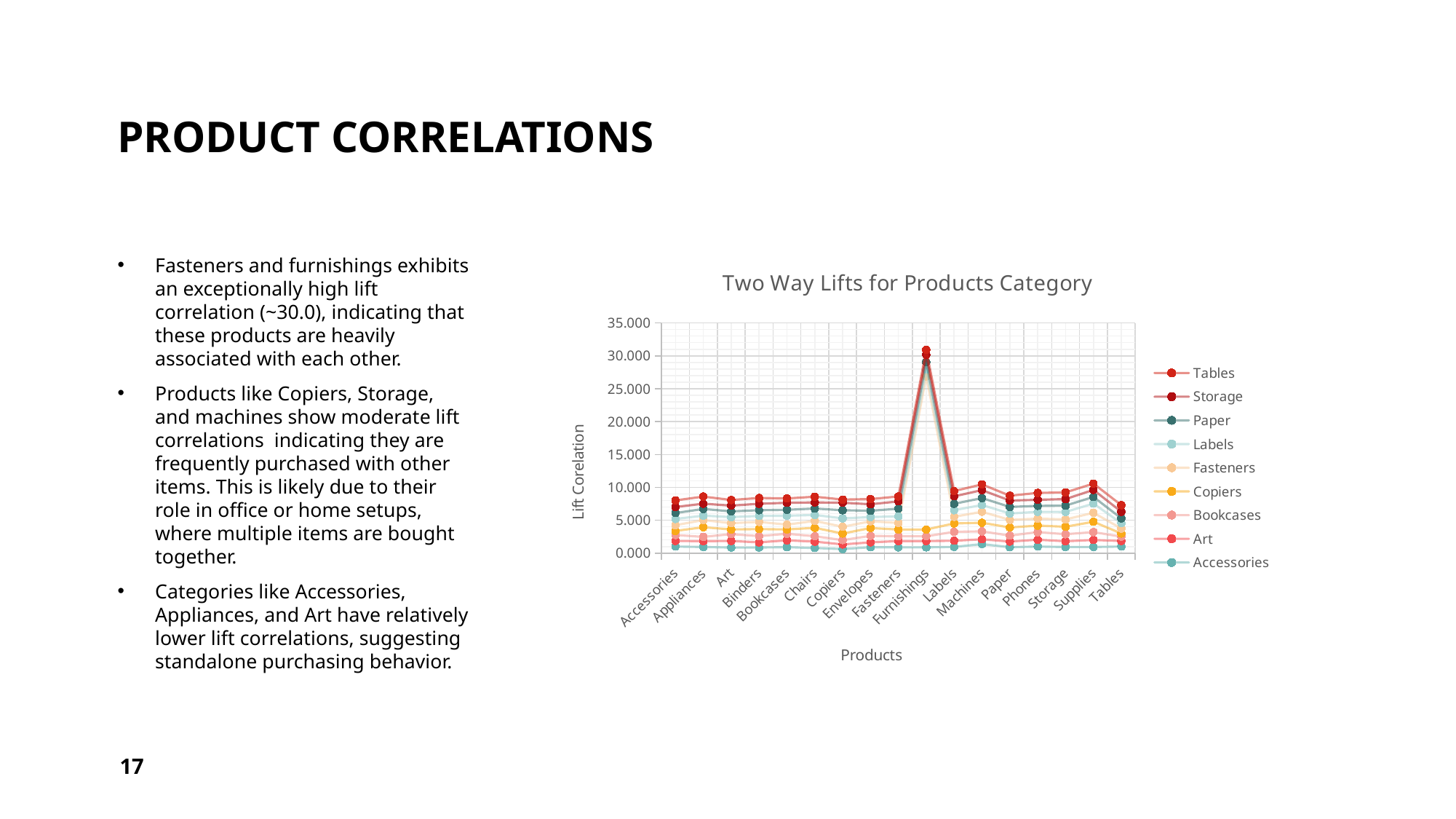
What is the title of the chart? Two Way Lifts for Products Category How many series does the chart legend list? 9 What kind of chart is shown on the slide? Line chart Which series is listed first in the chart legend? Tables Is the value for the Copiers series at Furnishings greater or less than 10.000? less How many product categories are shown along the x axis of the chart? 17 What is the label of the vertical axis of the chart? Lift Corelation Is the value for the Accessories series at Accessories greater or less than 5.000? less